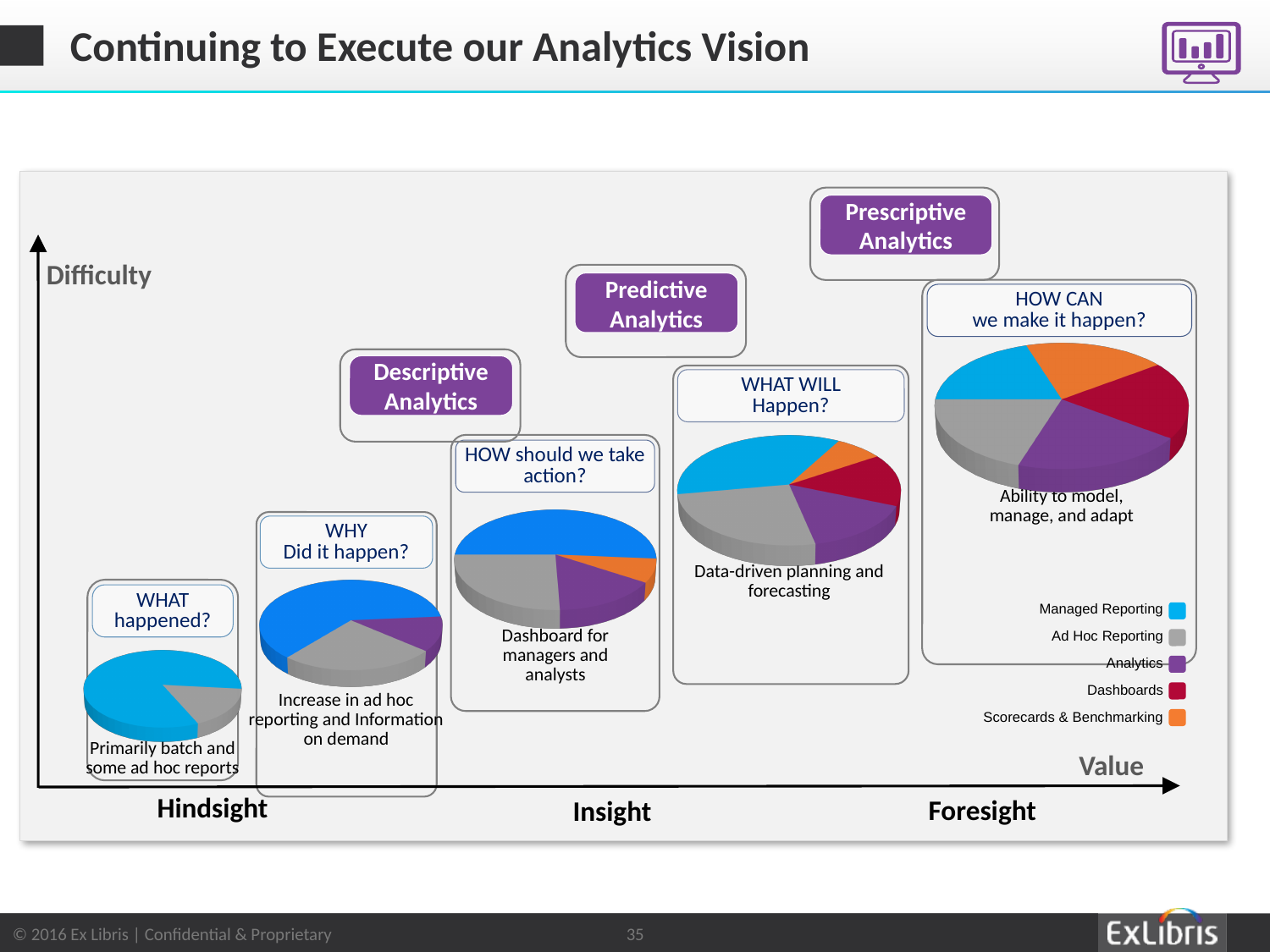
In the "HOW should we take action?" pie chart, which series has the smallest slice? Scorecards & Benchmarking In the "WHAT happened?" pie chart, how many slices are there? 2 In the "WHAT WILL Happen?" pie chart, which series has the smallest slice? Scorecards & Benchmarking What are the labels on the vertical and horizontal axes of the diagram? Difficulty and Value How many pie charts are shown on the slide? 5 Which legend entry is shown in red? Dashboards In the "HOW should we take action?" pie chart, how many slices are there? 4 In the "WHAT happened?" pie chart, which series has the largest slice? Managed Reporting What kind of chart is used in the "WHAT happened?" box? Pie chart In the "WHY Did it happen?" pie chart, which series has the smallest slice? Analytics How many series does the legend list? 5 In the "WHY Did it happen?" pie chart, which series has the largest slice? Managed Reporting